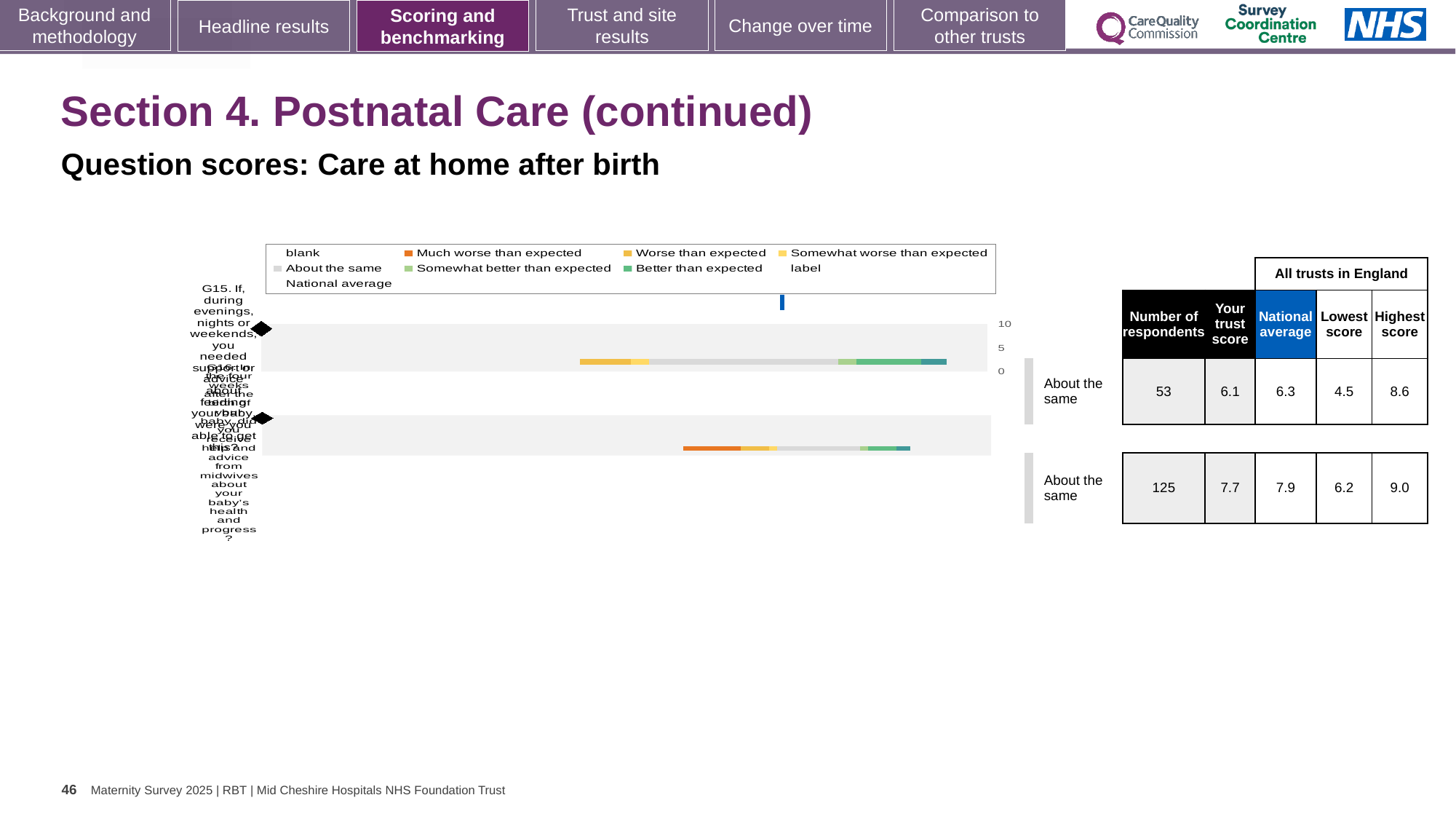
What kind of chart is shown on the slide? bar chart What benchmark category label is shown beside both rows of the chart? About the same For the top row, what is the difference between the highest score and the lowest score? 4.1 In the table next to the chart, what is the highest score for the top row? 8.6 In the table next to the chart, what is 'Your trust score' for the bottom row? 7.7 For the bottom row, which is larger: the trust score or the national average? National average In the table next to the chart, what is the number of respondents for the bottom row? 125 In the table next to the chart, what is the national average for the top row? 6.3 In the table next to the chart, what is 'Your trust score' for the top row? 6.1 In the table next to the chart, what is the number of respondents for the top row? 53 How many question rows (bars) are plotted in the chart? 2 For the bottom row, what is the difference between the highest score and the lowest score? 2.8